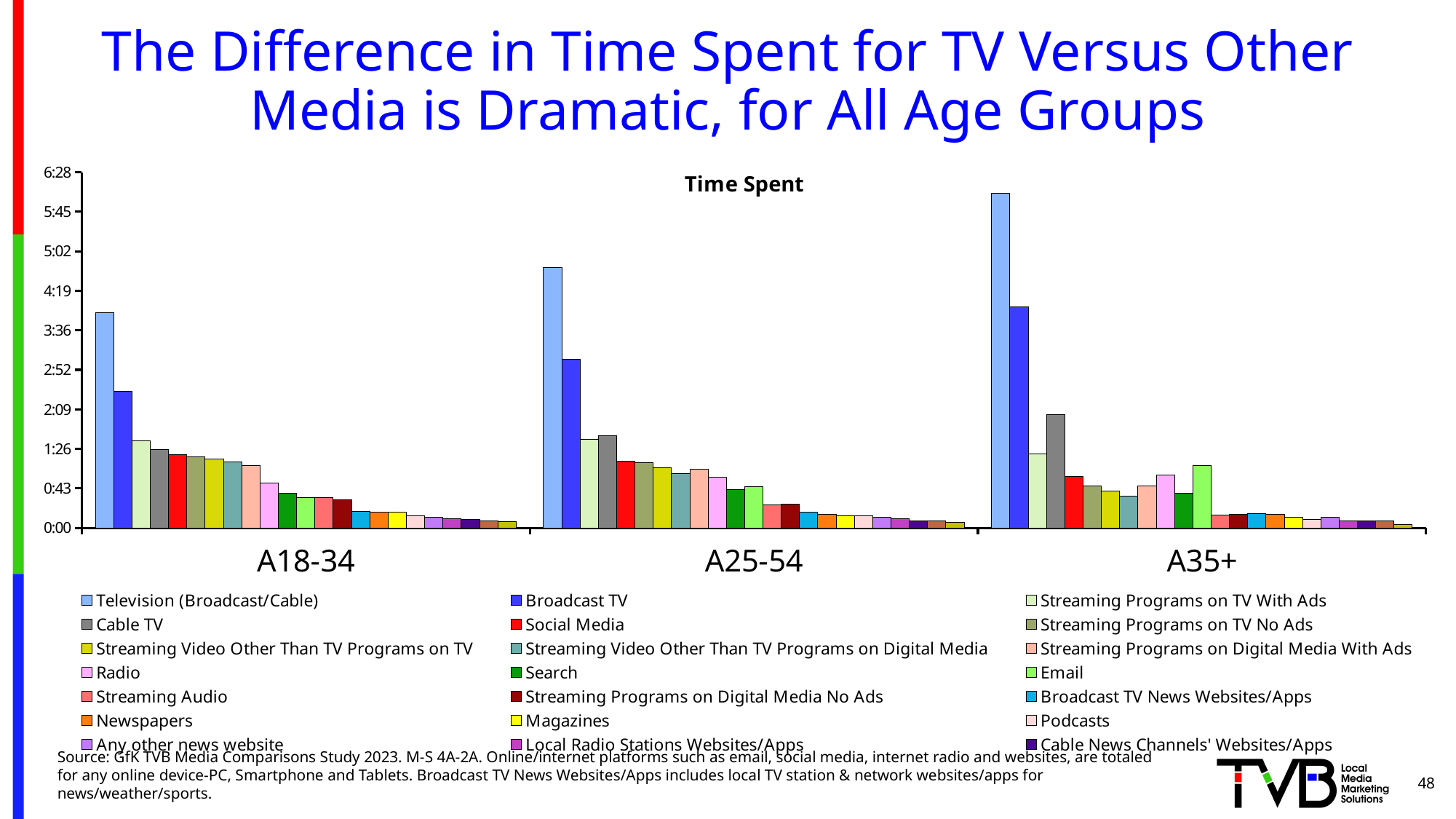
Which age group is shown in the middle position on the x axis? A25-54 Is the value for Broadcast TV in the A18-34 group greater or less than 2:09? greater In the A25-54 group, which is larger: Television (Broadcast/Cable) or Broadcast TV? Television (Broadcast/Cable) How many series does the chart's legend list? 21 Which series has the tallest bar in the A35+ group? Television (Broadcast/Cable) Is the value for Television (Broadcast/Cable) in the A35+ group greater or less than 5:02? greater Is the value for Television (Broadcast/Cable) in the A18-34 group greater or less than 3:36? greater What is the title printed above the chart's plot area? Time Spent Does the Television (Broadcast/Cable) bar rise or fall moving from A18-34 to A35+ along the x axis? rise How many age groups are shown on the x axis of the chart? 3 In which age group is the Television (Broadcast/Cable) bar the tallest? A35+ What kind of chart is shown on the slide? bar chart